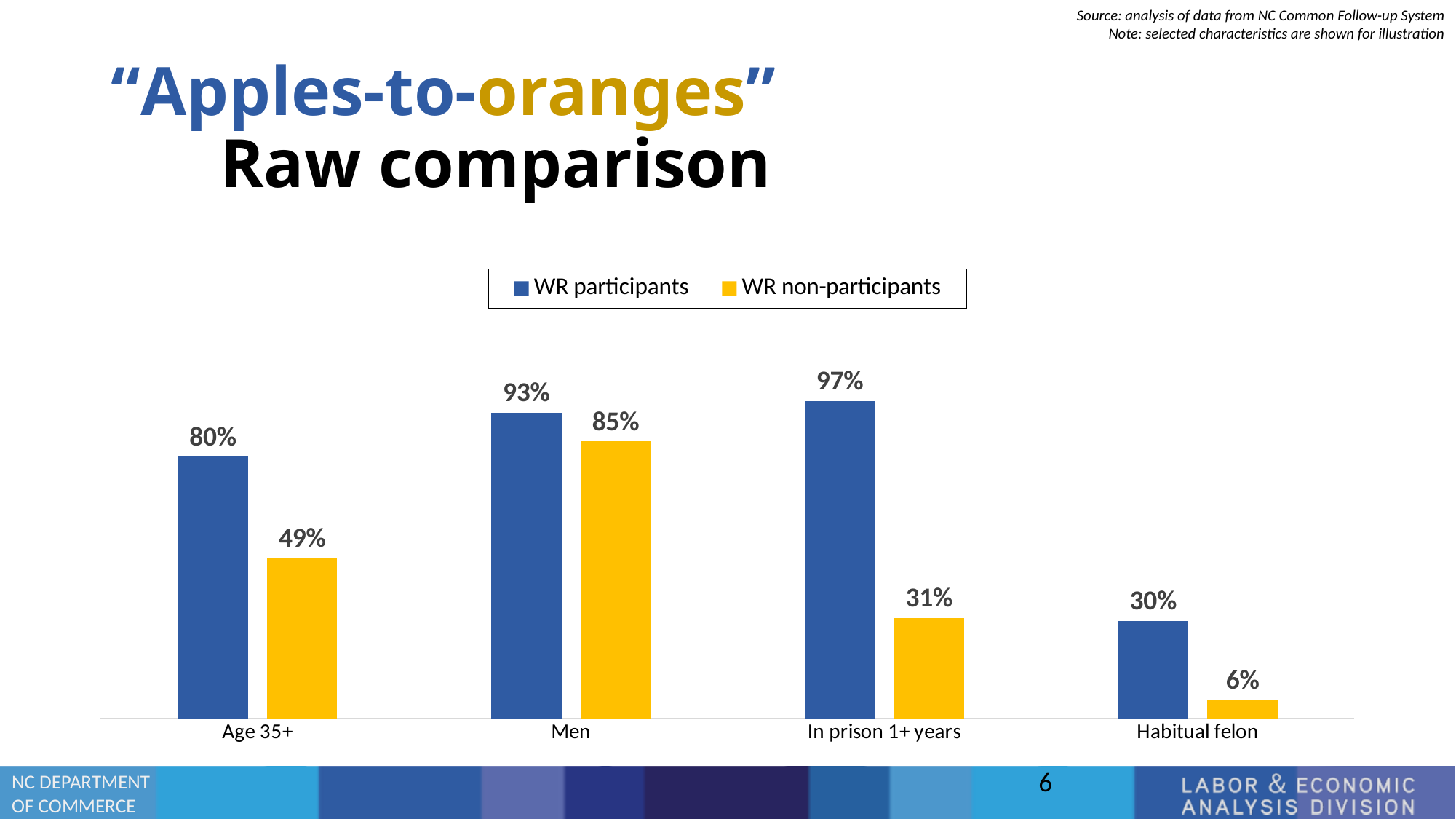
How many series does the legend list? 2 Which category has the highest value for WR participants? In prison 1+ years What is the value for WR participants in the Age 35+ category? 80% What is the difference between WR participants and WR non-participants in the In prison 1+ years category? 66% Which is larger in the Age 35+ category: WR participants or WR non-participants? WR participants What colour are the bars for WR non-participants? Yellow What is the value for WR non-participants in the Habitual felon category? 6% What is the value for WR non-participants in the In prison 1+ years category? 31% How many categories are shown on the x axis? 4 Which category has the lowest value for WR non-participants? Habitual felon What is the difference between WR participants and WR non-participants in the Men category? 8% What kind of chart is shown on the slide? Bar chart